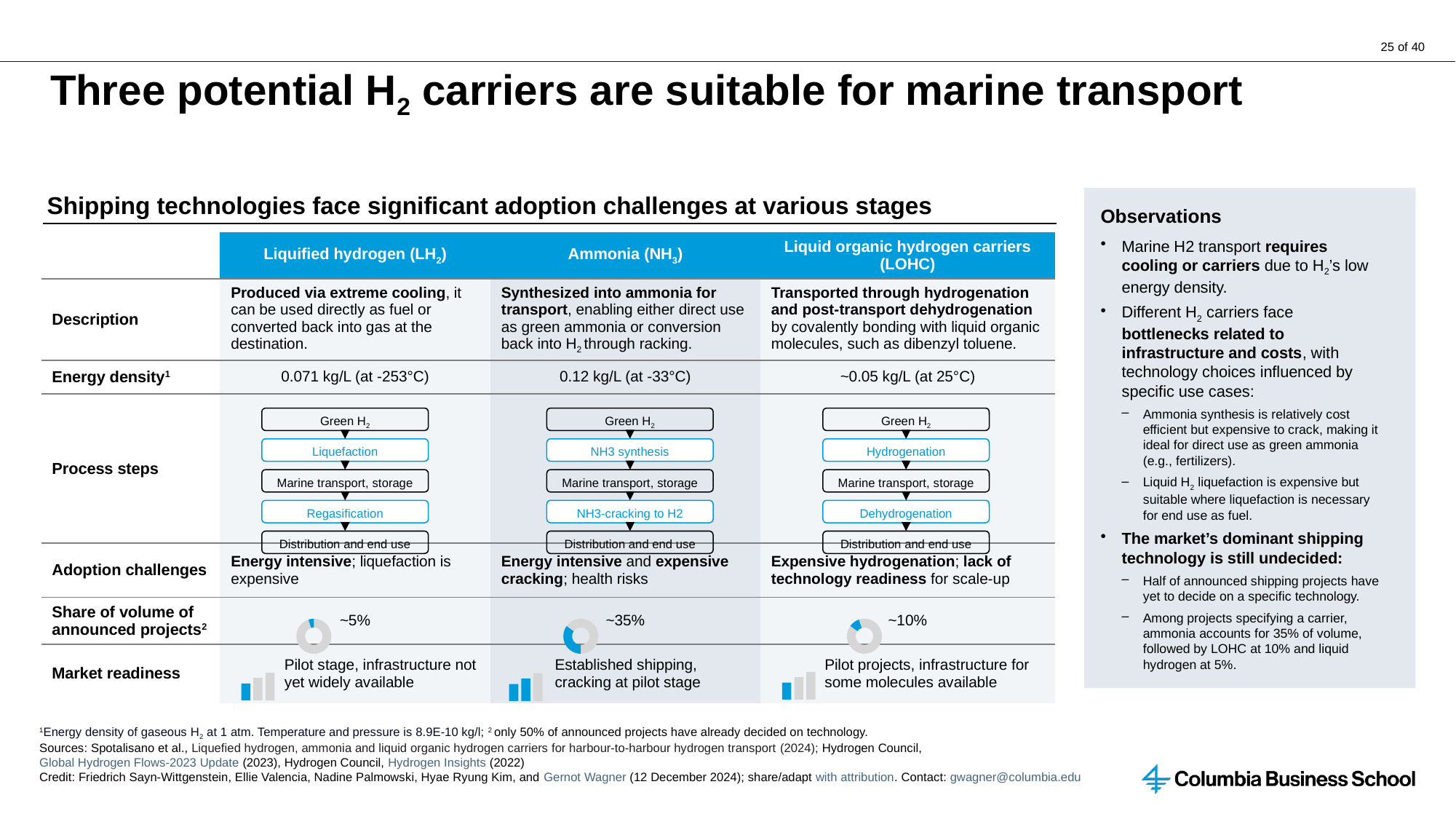
In the 'Share of volume of announced projects' row, which is larger: the share for Ammonia (NH3) or for Liquid organic hydrogen carriers (LOHC)? Ammonia (NH3) In the 'Share of volume of announced projects' row, which is larger: the share for Liquified hydrogen (LH2) or for Liquid organic hydrogen carriers (LOHC)? Liquid organic hydrogen carriers (LOHC) What kind of chart is used in the 'Share of volume of announced projects' row? Doughnut chart In the 'Share of volume of announced projects' row, what share is printed next to the chart for Liquid organic hydrogen carriers (LOHC)? ~10% In the 'Share of volume of announced projects' row, which carrier has the largest share? Ammonia (NH3) In the 'Share of volume of announced projects' row, what share is printed next to the chart for Liquified hydrogen (LH2)? ~5% What colour is used for the highlighted slice in the small charts in the 'Share of volume of announced projects' row? Blue In the 'Share of volume of announced projects' row, what share is printed next to the chart for Ammonia (NH3)? ~35% Which table row contains the small pie charts on the slide? Share of volume of announced projects In the 'Share of volume of announced projects' row, which carrier has the smallest share? Liquified hydrogen (LH2) How many small charts are shown in the 'Share of volume of announced projects' row? 3